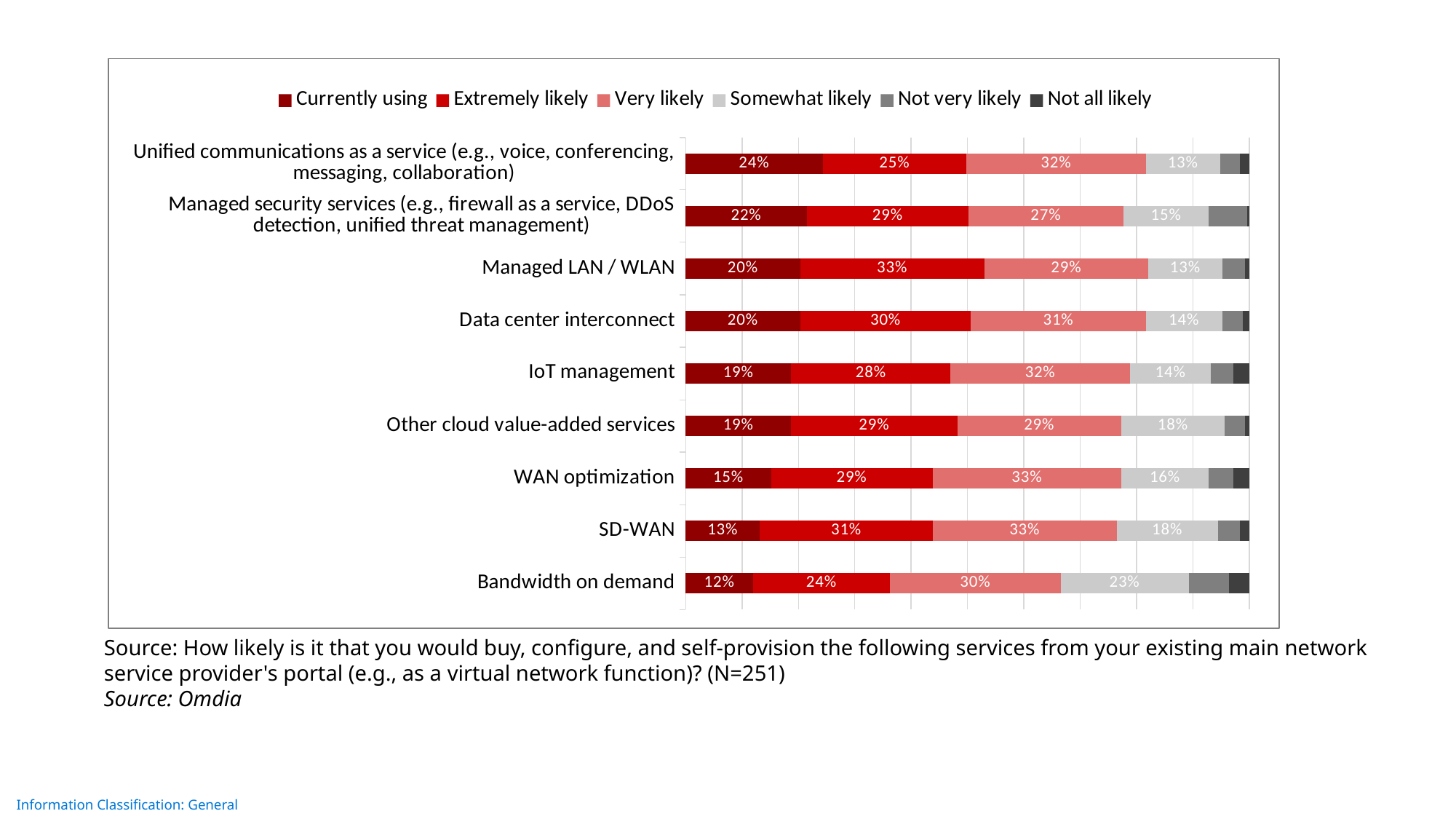
What kind of chart is shown on the slide? Stacked bar chart Which has a larger 'Very likely' value: SD-WAN or Data center interconnect? SD-WAN How many series does the legend list? 6 Which service has the highest 'Currently using' percentage? Unified communications as a service Which service has the lowest 'Currently using' percentage? Bandwidth on demand How many percentage points higher is the 'Extremely likely' value for Managed LAN / WLAN than for Bandwidth on demand? 9 percentage points What percentage of respondents are currently using unified communications as a service? 24% Which service has the highest 'Extremely likely' percentage? Managed LAN / WLAN What is the 'Somewhat likely' value for Bandwidth on demand? 23% What is the 'Very likely' value for IoT management? 32% What is the 'Extremely likely' value for Managed LAN / WLAN? 33% How many services are listed in the chart? 9